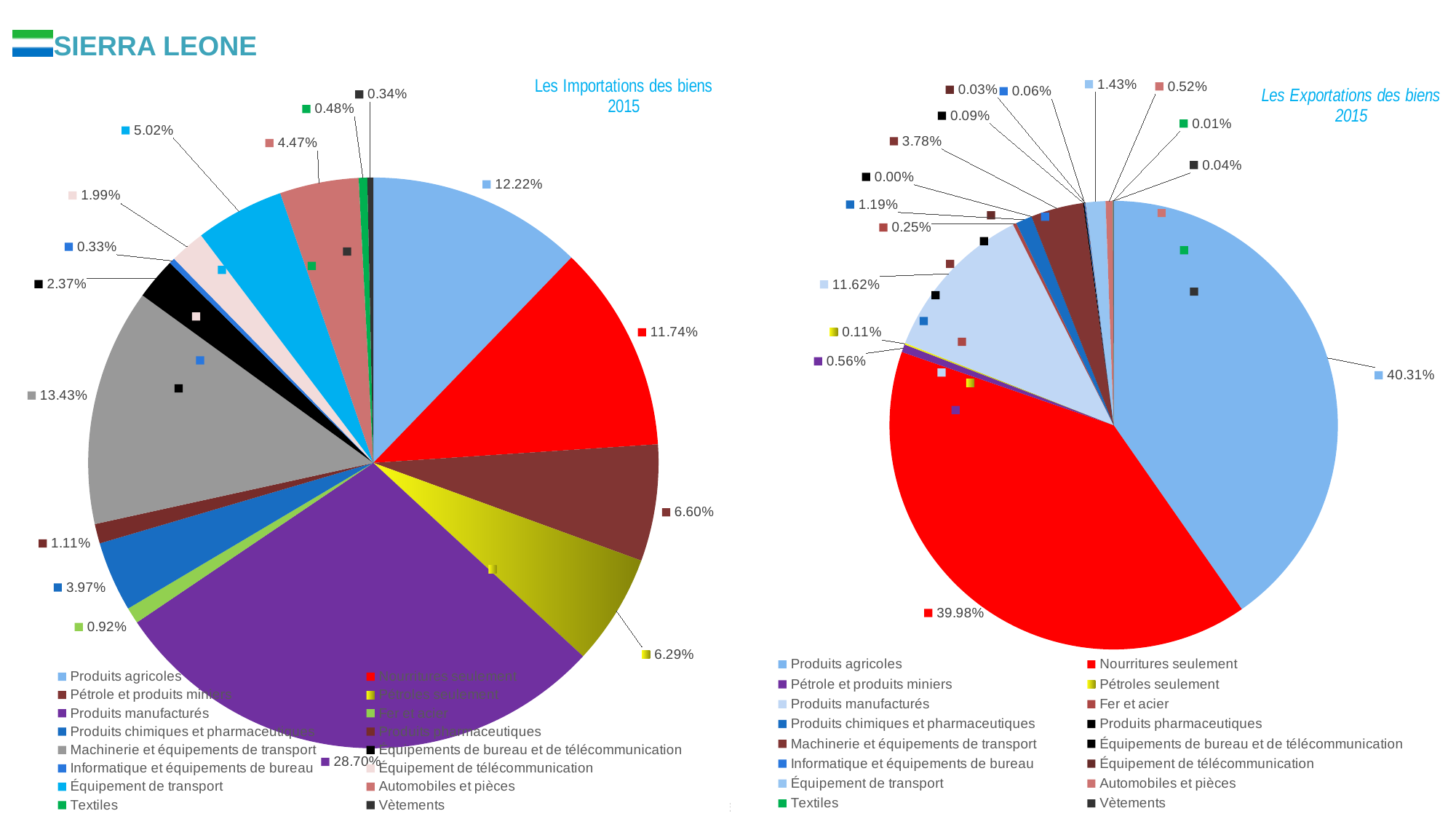
In 'Les Exportations des biens 2015', what is the difference between Produits agricoles (40.31%) and Nourritures seulement (39.98%)? 0.33% In 'Les Importations des biens 2015', which category has the largest share? Produits manufacturés In 'Les Importations des biens 2015', what is the share for Produits manufacturés? 28.70% In 'Les Exportations des biens 2015', what is the share for Nourritures seulement? 39.98% In 'Les Exportations des biens 2015', what is the share for Produits agricoles? 40.31% In 'Les Importations des biens 2015', what is the difference between Produits agricoles (12.22%) and Nourritures seulement (11.74%)? 0.48% In 'Les Exportations des biens 2015', what is the share for Produits manufacturés? 11.62% In 'Les Importations des biens 2015', what is the share for Machinerie et équipements de transport? 13.43% What kind of chart is 'Les Importations des biens 2015'? pie chart In 'Les Importations des biens 2015', which is larger: Produits agricoles or Nourritures seulement? Produits agricoles How many entries does the legend of 'Les Exportations des biens 2015' list? 16 How many pie charts are shown on the slide? 2